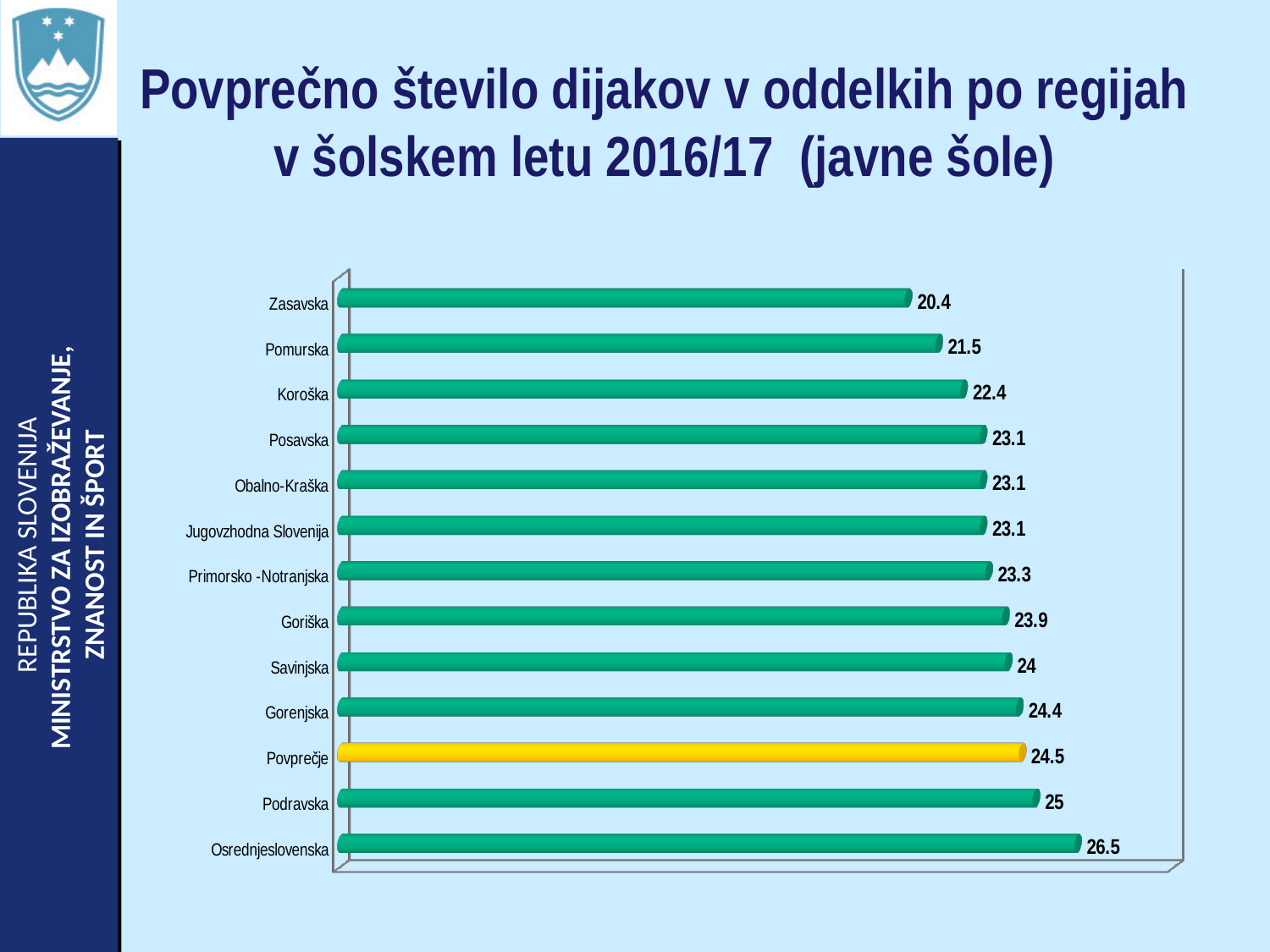
What kind of chart is shown on the slide? Bar chart Which category has the highest value? Osrednjeslovenska Which category has the lowest value? Zasavska What is the value for Povprečje? 24.5 How many categories are shown in the chart? 13 What is the value for Gorenjska? 24.4 What is the difference between the values for Podravska and Povprečje? 0.5 What is the difference between the values for Osrednjeslovenska and Zasavska? 6.1 Which bar is coloured differently (yellow) from the others? Povprečje What is the value for Zasavska? 20.4 Which is larger, the value for Pomurska or the value for Savinjska? Savinjska Which is larger, the value for Koroška or the value for Goriška? Goriška